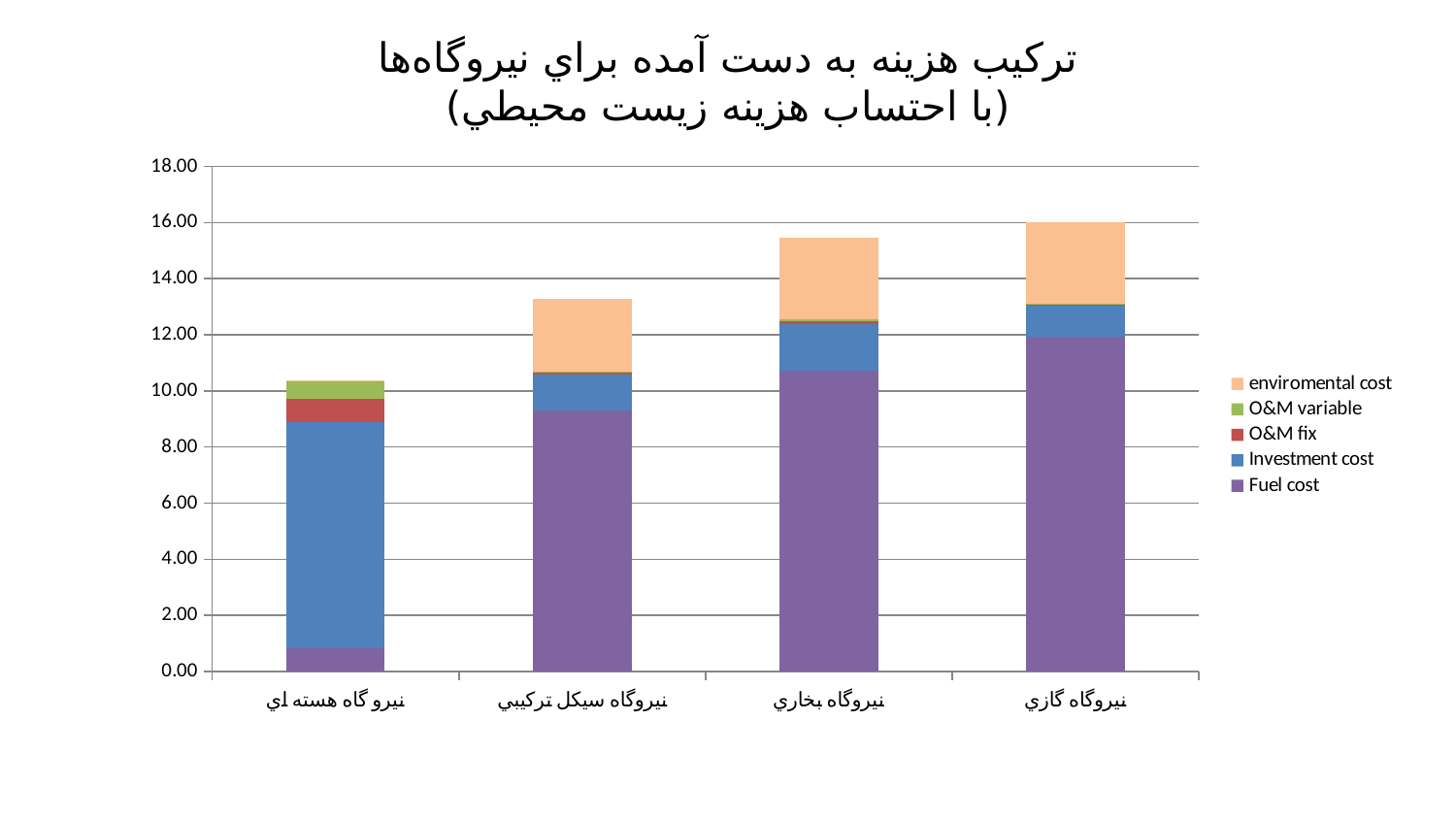
What kind of chart is shown on the slide? Stacked bar chart How many power plant categories are shown on the x axis? 4 How many series does the legend list? 5 Which power plant category has the highest total stacked bar? نیروگاه گازی Which series is shown in the orange colour at the top of the stacked bars? enviromental cost Is the total bar for نیروگاه سیکل ترکیبی greater or less than 12.00? greater Which power plant category has the lowest total stacked bar? نیروگاه هسته‌ای Is the Fuel cost segment for نیروگاه هسته‌ای greater or less than 2.00? less Is the total bar for نیروگاه گازی greater or less than 14.00? greater Which power plant category has the largest Investment cost segment? نیروگاه هسته‌ای Which has the larger total bar, نیروگاه بخاری or نیروگاه سیکل ترکیبی? نیروگاه بخاری